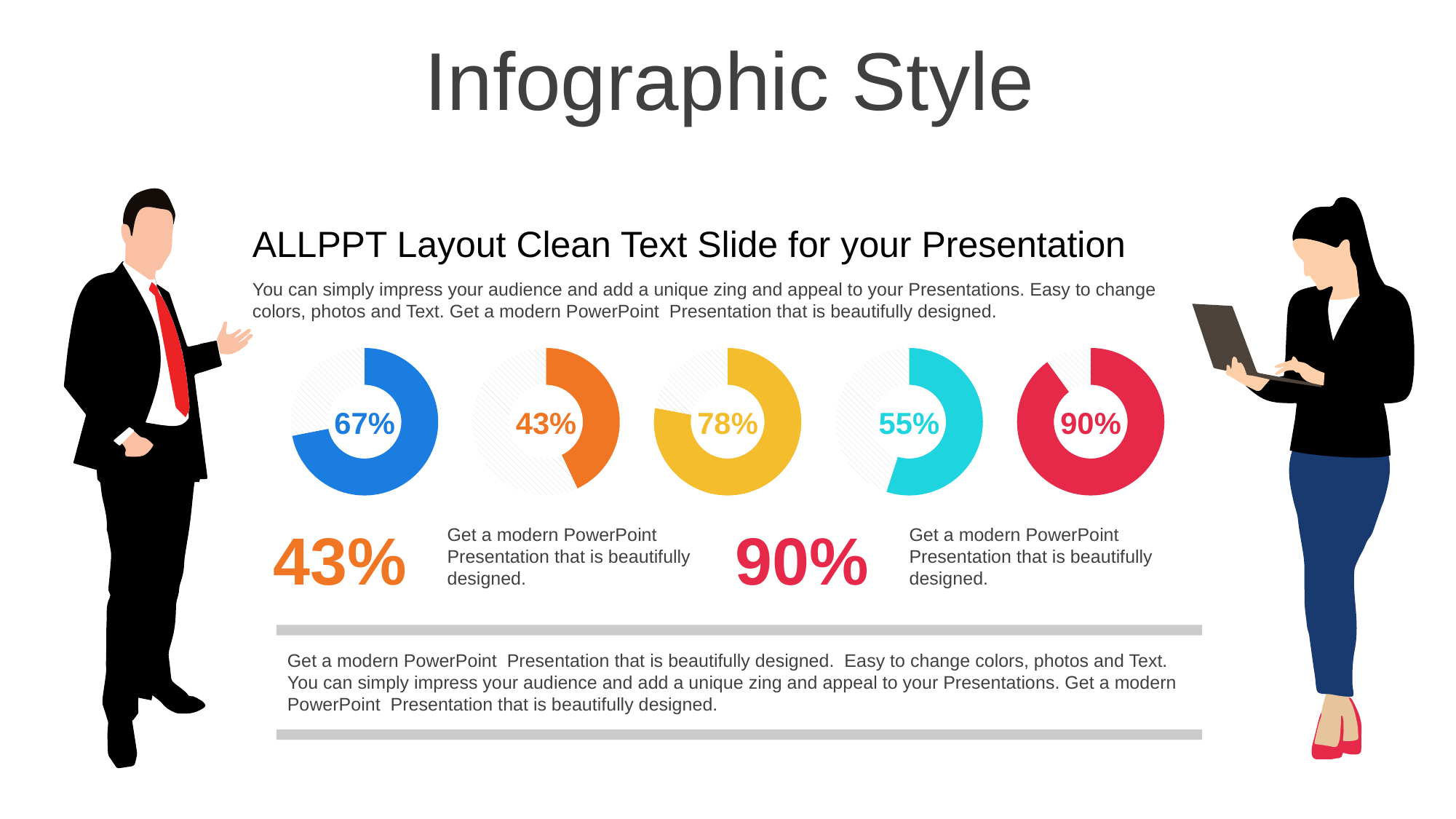
Which donut chart shows the lowest percentage? The orange one (43%) What is the difference between the value in the yellow donut chart and the value in the blue donut chart? 11% Which is larger, the value in the blue donut chart or the value in the cyan donut chart? The blue donut chart (67%) What value is shown in the orange donut chart (second from the left)? 43% What value is shown in the red donut chart (rightmost)? 90% What value is shown in the blue donut chart (first from the left)? 67% What value is shown in the yellow donut chart (middle)? 78% What kind of charts are used to display the percentages on the slide? Donut charts What is the difference between the value in the red donut chart and the value in the orange donut chart? 47% What value is shown in the cyan donut chart (fourth from the left)? 55% Which donut chart shows the highest percentage? The red one (90%) How many donut charts are shown on the slide? 5